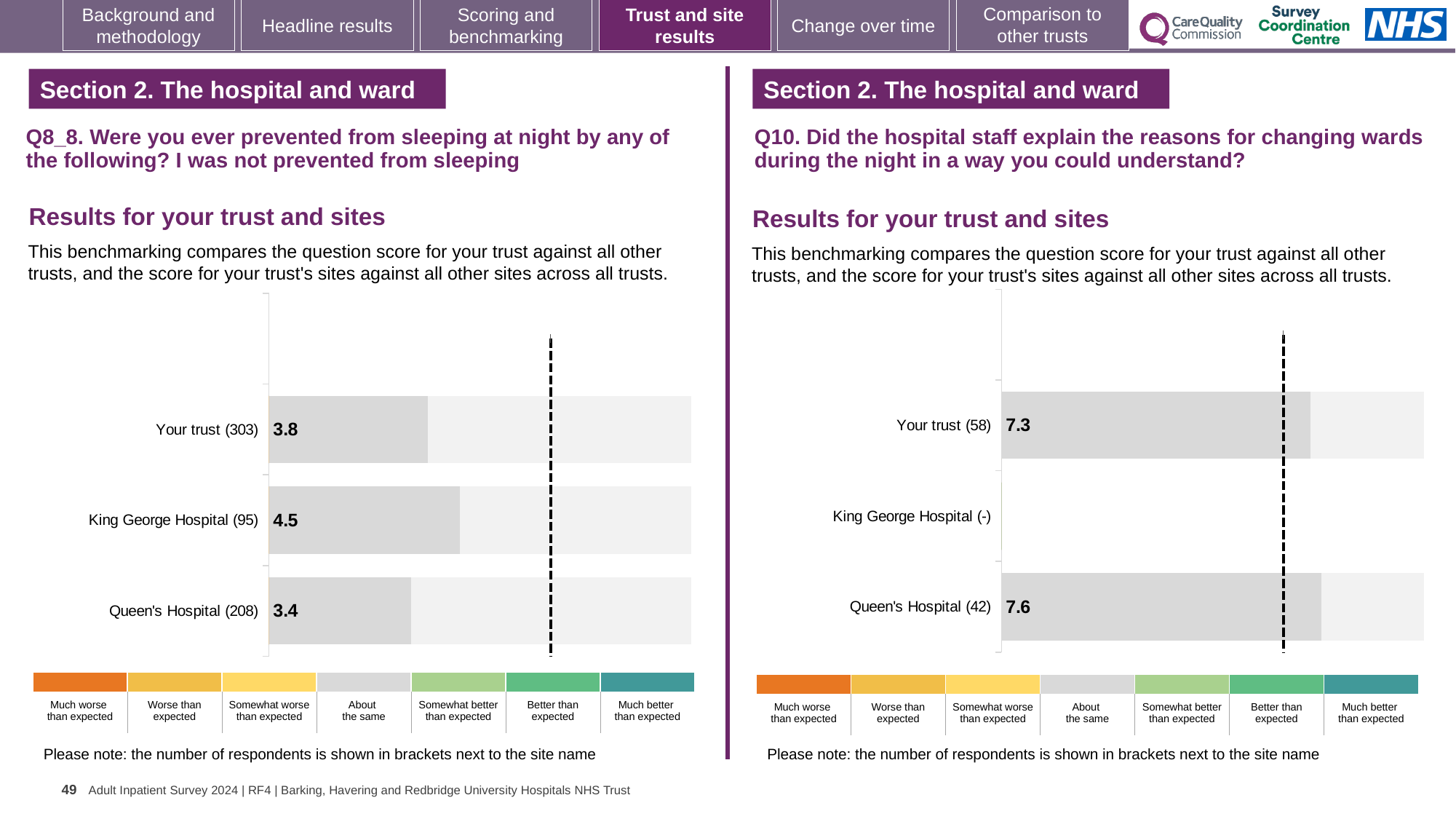
In the Q10 chart on the right, what is the score for Your trust? 7.3 In the Q10 chart on the right, which has the larger score, Your trust or Queen's Hospital? Queen's Hospital In the Q8_8 chart on the left, how many respondents are shown in brackets for Queen's Hospital? 208 In the Q8_8 chart on the left, which site or trust has the lowest score? Queen's Hospital In the Q8_8 chart on the left, what is the score for Your trust? 3.8 In the Q10 chart on the right, what is the score for Queen's Hospital? 7.6 In the Q8_8 chart on the left, what is the score for Queen's Hospital? 3.4 In the Q10 chart on the right, what is the difference between the scores for Queen's Hospital and Your trust? 0.3 In the Q8_8 chart on the left, what is the difference between the scores for King George Hospital and Queen's Hospital? 1.1 In the Q8_8 chart on the left, which site or trust has the highest score? King George Hospital What kind of chart is used on the left for Q8_8? Bar chart In the Q8_8 chart on the left, what is the score for King George Hospital? 4.5